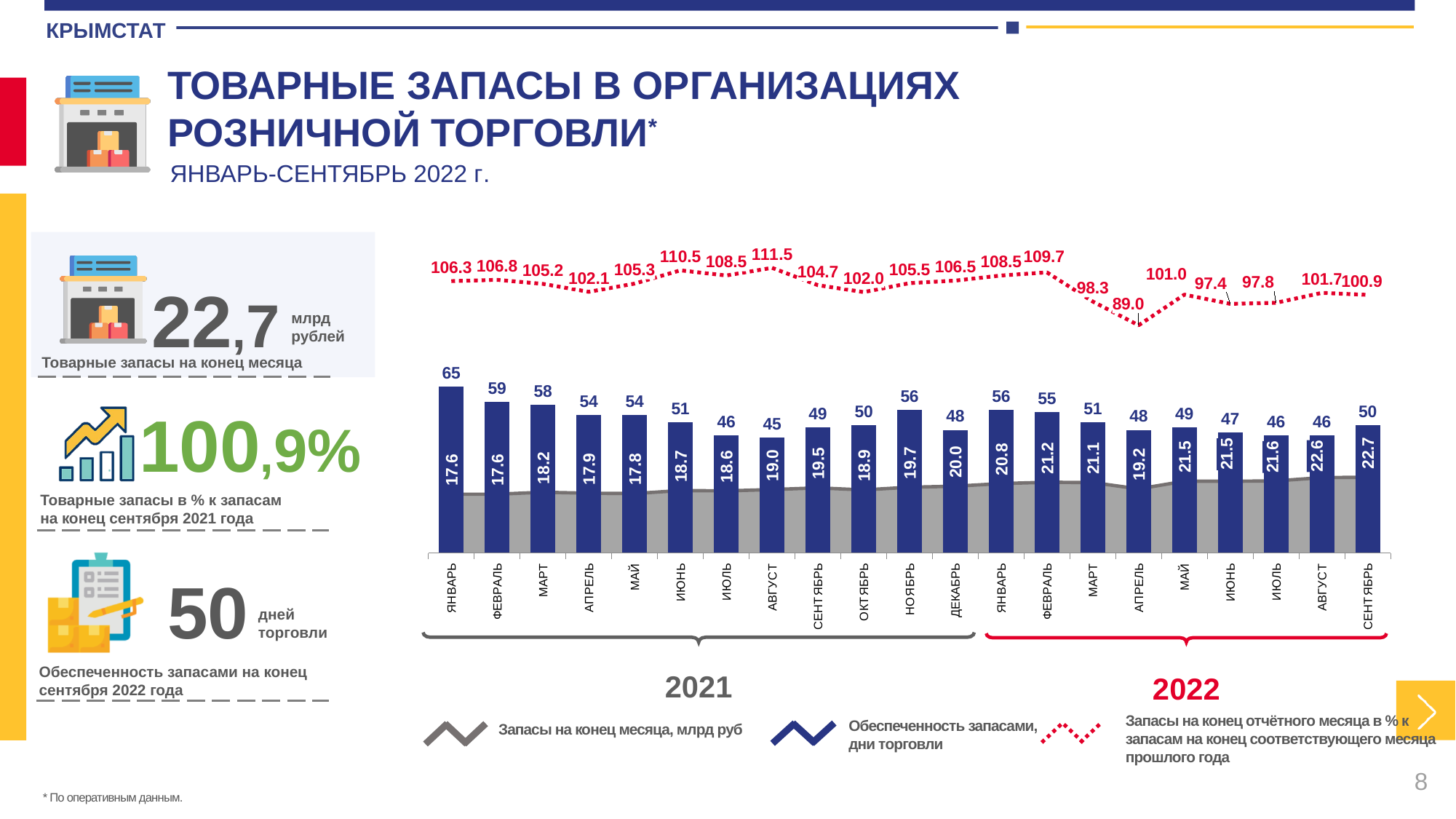
What is the value of the dotted line (stocks in % to the same month of the previous year) for апрель 2022? 89.0 What kind of chart is used for the trading-days series? Bar chart What are the stocks at the end of the month (Запасы на конец месяца, млрд руб) for август 2022? 22.6 What is the highest value on the dotted line (stocks in % to the previous year) and in which month? 111.5, август 2021 How many series does the chart legend list? 3 What is the stock provision in trading days (Обеспеченность запасами, дни торговли) for сентябрь 2022? 50 Which month has the highest stock provision in trading days? Январь 2021 What is the difference in trading days between январь 2021 (65) and январь 2022 (56)? 9 Do the stocks at the end of the month (млрд руб) generally rise or fall from январь 2021 to сентябрь 2022? Rise Which month has the lowest value on the dotted line (stocks in % to the previous year)? Апрель 2022 How many months are shown on the x axis of the chart? 21 Which is larger: stocks at the end of the month in декабрь 2021 or in сентябрь 2022? Сентябрь 2022